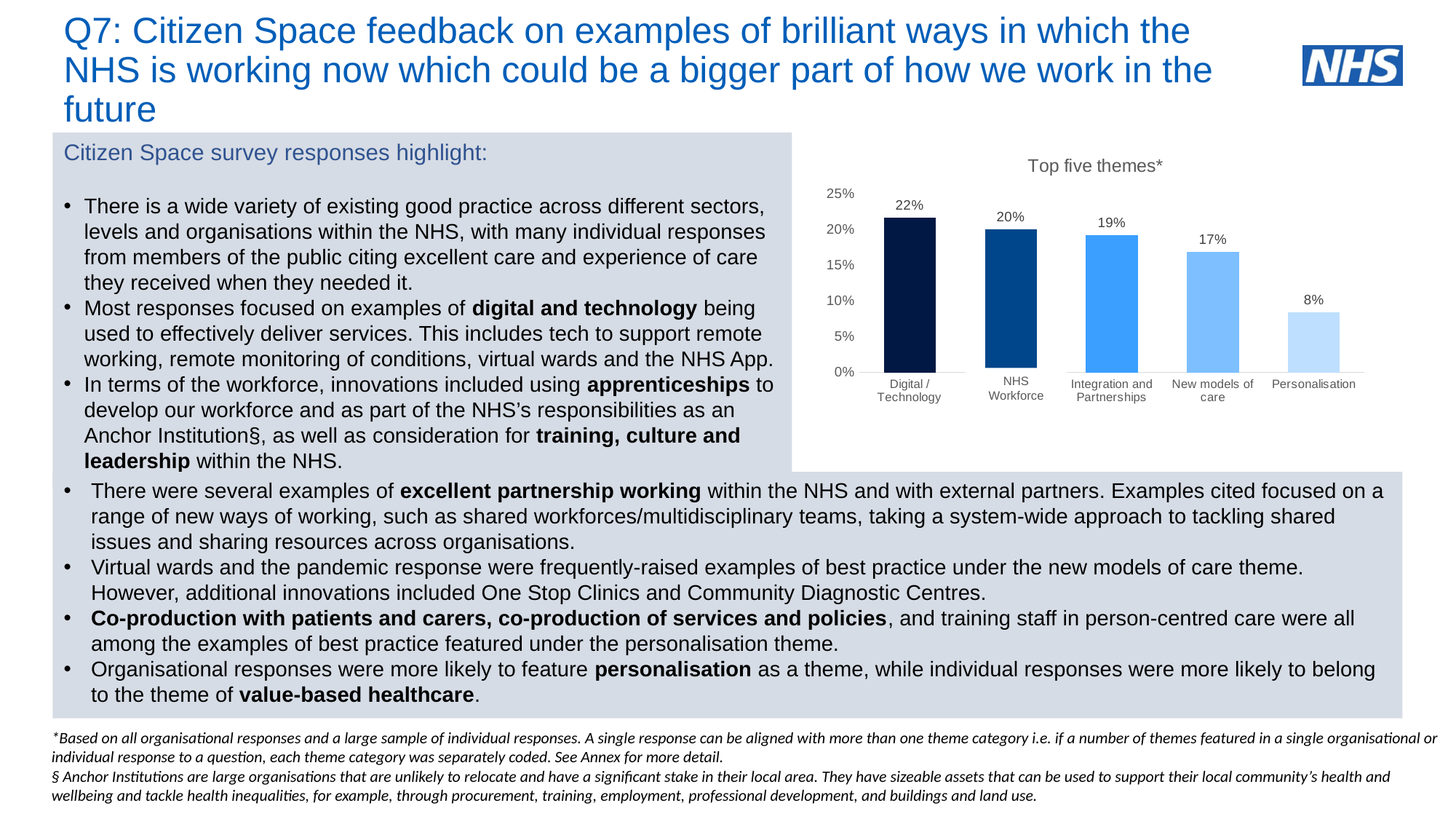
What kind of chart is shown on the slide? Bar chart How many themes are shown in the chart? 5 What is the title of the chart? Top five themes* Which is larger, the value for New models of care or the value for Personalisation? New models of care What is the value for Integration and Partnerships? 19% What is the value for Digital / Technology? 22% What is the value for NHS Workforce? 20% Which theme has the lowest value? Personalisation What is the difference between the values for Digital / Technology and Personalisation? 14% What is the value for Personalisation? 8% What is the difference between the values for NHS Workforce and New models of care? 3% Which theme has the highest value? Digital / Technology